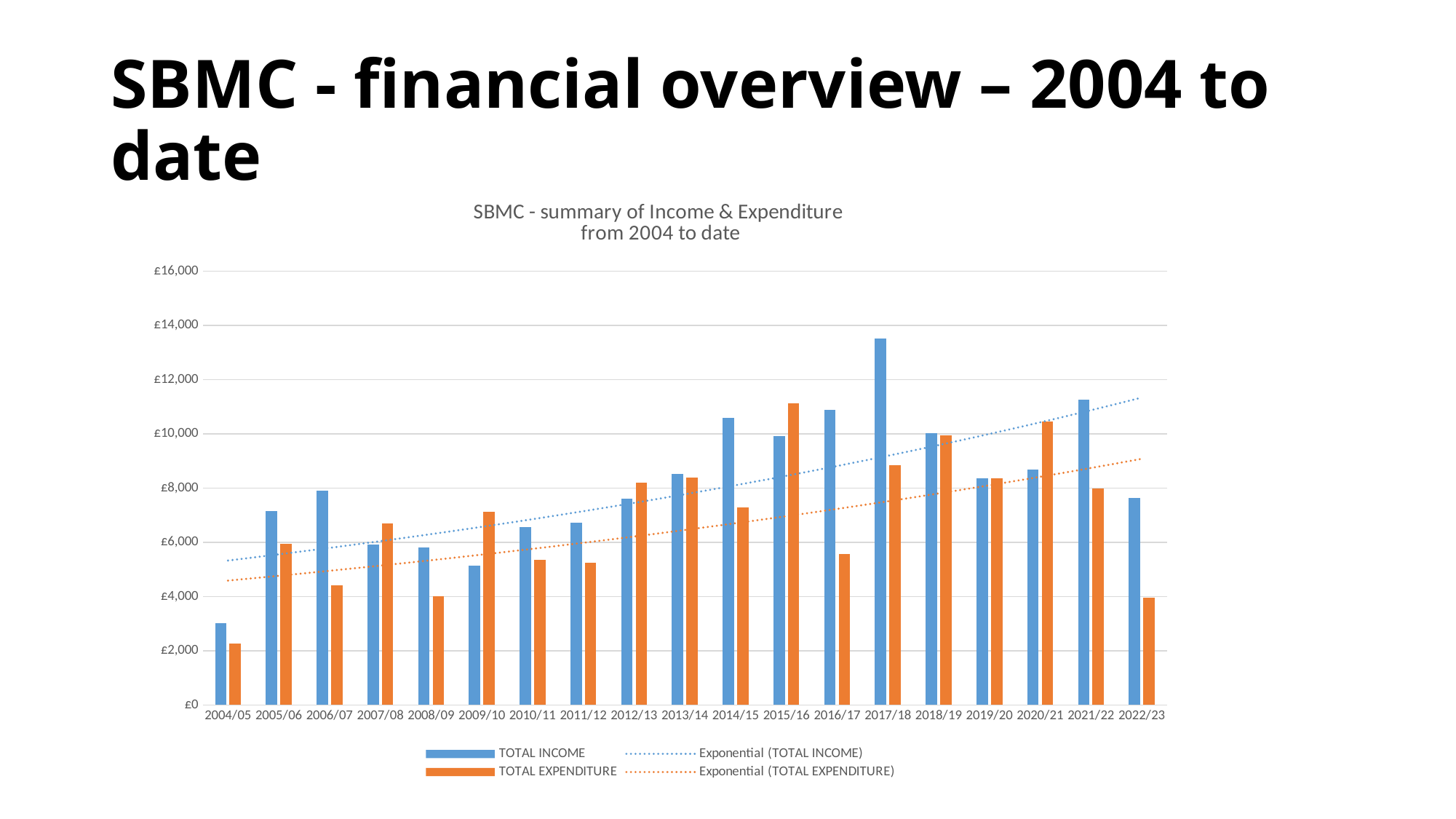
In 2015/16, which is larger, TOTAL INCOME or TOTAL EXPENDITURE? TOTAL EXPENDITURE Is the TOTAL INCOME value for 2004/05 greater or less than £4,000? less In which year is TOTAL EXPENDITURE highest? 2015/16 In which year is TOTAL INCOME highest? 2017/18 What kind of chart is shown on the slide? bar chart How many financial years are shown on the x axis of the chart? 19 How many entries does the chart's legend list? 4 In which year is TOTAL INCOME lowest? 2004/05 Does the Exponential (TOTAL INCOME) trend line rise or fall from 2004/05 to 2022/23? rise In 2016/17, which is larger, TOTAL INCOME or TOTAL EXPENDITURE? TOTAL INCOME Is the TOTAL EXPENDITURE value for 2016/17 greater or less than £6,000? less Is the TOTAL INCOME value for 2017/18 greater or less than £12,000? greater